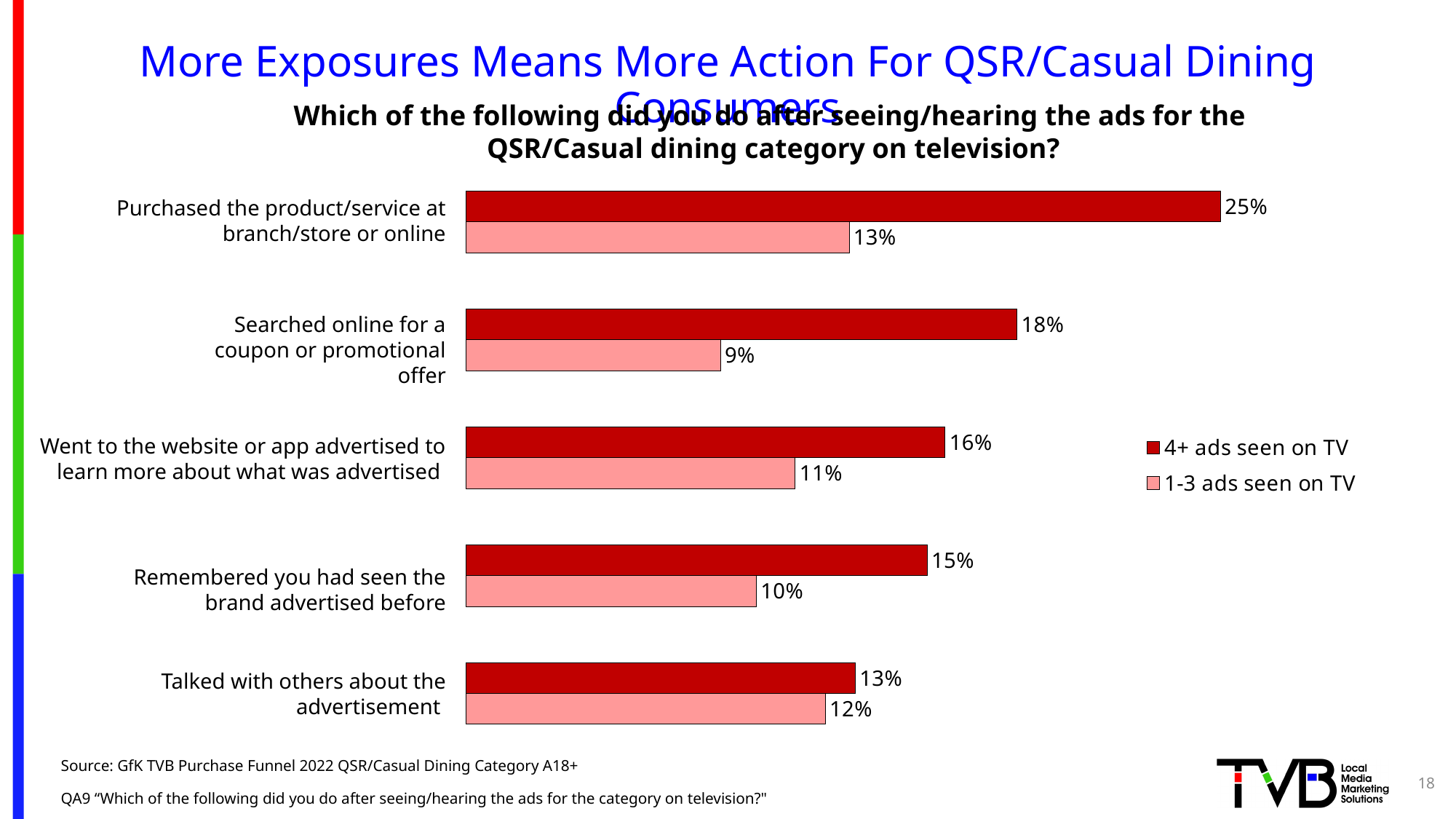
Which action has the highest value for the 4+ ads seen on TV series? Purchased the product/service at branch/store or online How many series does the legend list? 2 Which action has the lowest value for the 1-3 ads seen on TV series? Searched online for a coupon or promotional offer What type of chart is shown on the slide? Bar chart What is the difference between the 4+ ads and 1-3 ads values for 'Talked with others about the advertisement'? 1 percentage point What is the difference between the 4+ ads and 1-3 ads values for 'Purchased the product/service at branch/store or online'? 12 percentage points For 'Went to the website or app advertised to learn more about what was advertised', which series has the larger value: 4+ ads seen on TV or 1-3 ads seen on TV? 4+ ads seen on TV What is the value for 'Talked with others about the advertisement' among those who saw 1-3 ads on TV? 12% How many actions (categories) are shown in the chart? 5 What percentage of those who saw 4+ ads on TV purchased the product/service at branch/store or online? 25% Which series is shown in dark red in the chart? 4+ ads seen on TV What percentage of those who saw 1-3 ads on TV searched online for a coupon or promotional offer? 9%